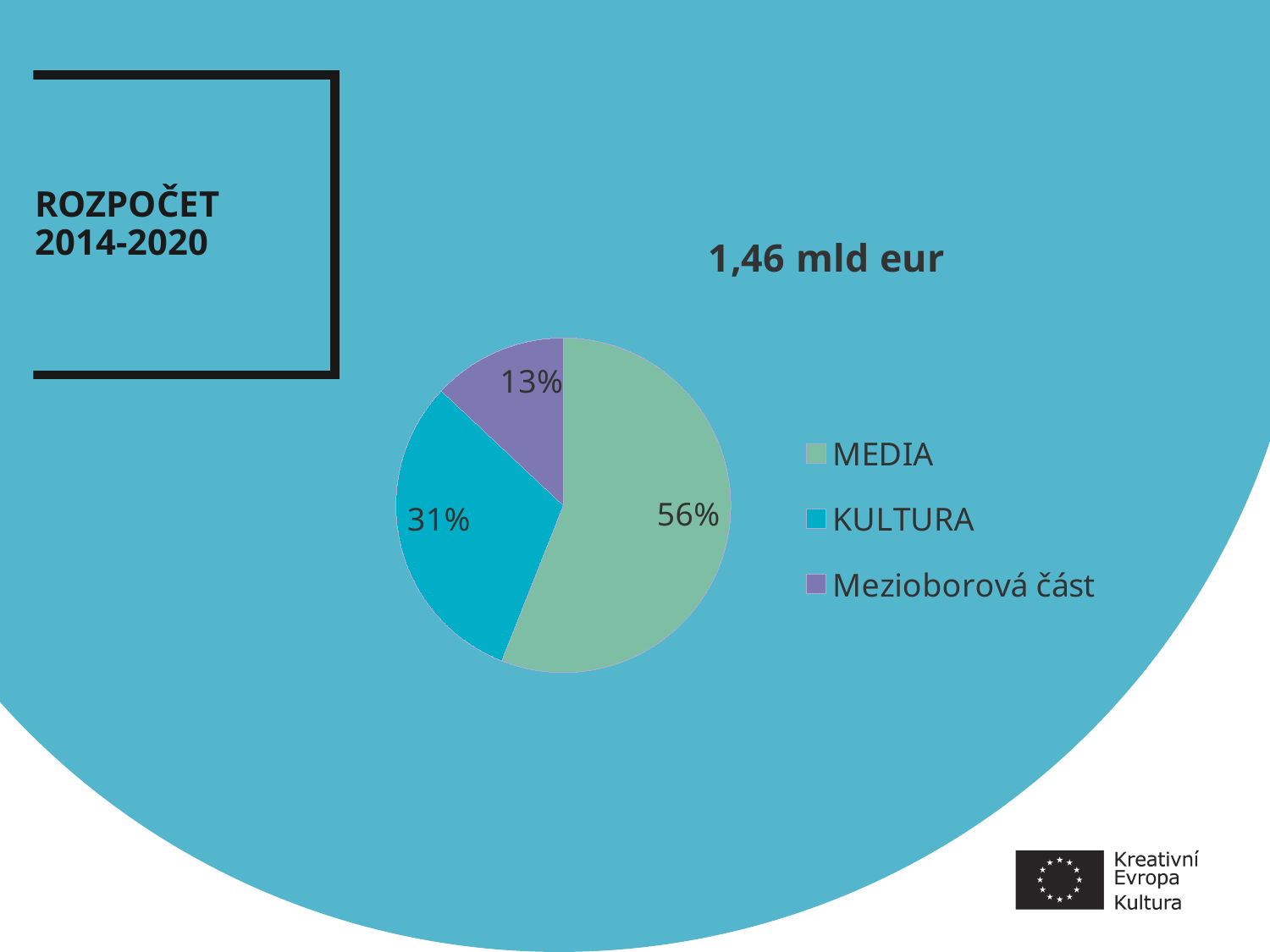
What total amount is shown above the pie chart? 1,46 mld eur What share of the pie does MEDIA have? 56% How many categories does the pie chart have? 3 Which category has the smallest slice of the pie? Mezioborová část Which is larger, the KULTURA slice or the Mezioborová část slice? KULTURA What colour is the KULTURA slice in the pie chart? blue What share of the pie does KULTURA have? 31% What is the difference in percentage points between the KULTURA and Mezioborová část slices? 18 What share of the pie does Mezioborová část have? 13% Which category has the largest slice of the pie? MEDIA What kind of chart is shown on the slide? pie chart What is the difference in percentage points between the MEDIA and KULTURA slices? 25